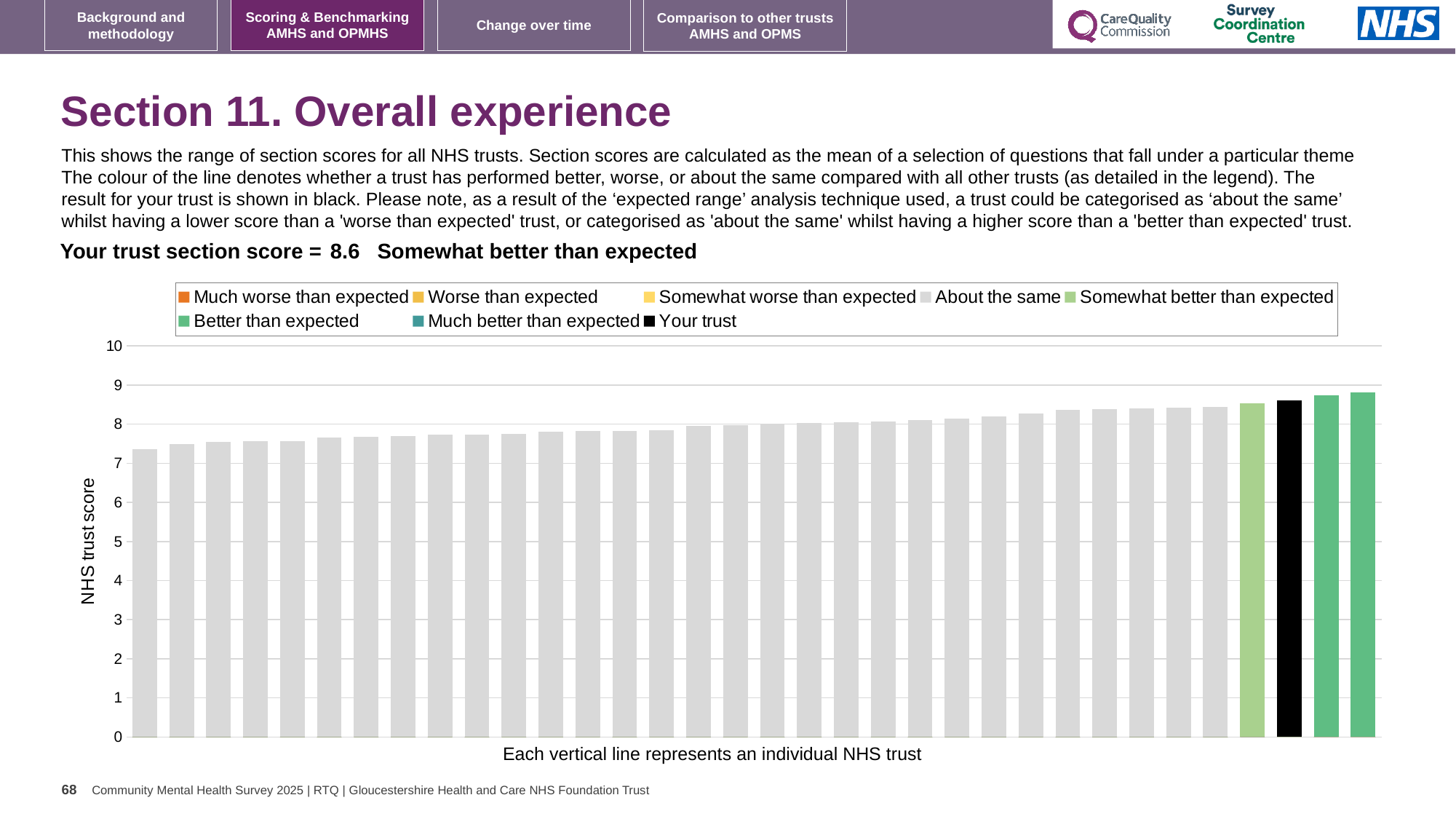
Is the value of the lowest-scoring trust (leftmost bar) greater or less than 7? greater Is the value for your trust greater or less than 8? greater What is your trust's section score for Section 11, Overall experience? 8.6 How many bars are to the right of the black 'Your trust' bar? 2 Do the trust scores rise or fall from left to right along the x axis? rise What is the highest value shown on the y axis? 10 Is your trust's bar the highest bar in the chart? No What kind of chart is shown on the slide? bar chart Which benchmarking category is your trust placed in for this section? Somewhat better than expected Is the value of the lowest-scoring trust (leftmost bar) greater or less than 8? less What colour is the bar representing your trust? black How many entries does the chart legend list? 8